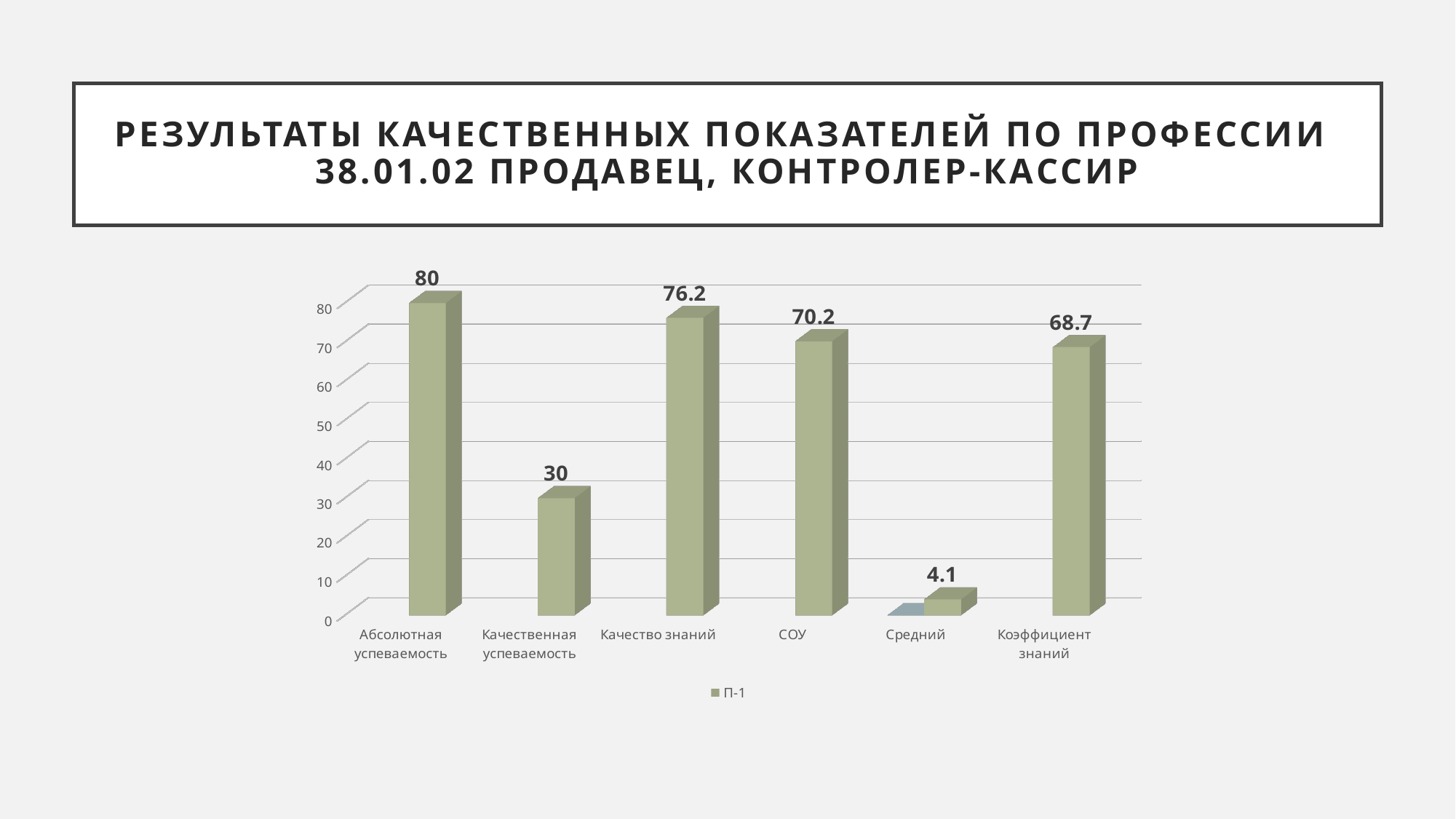
What is the value for Качественная успеваемость? 30 What is the difference between the values for Абсолютная успеваемость and Качественная успеваемость? 50 What is the value for Коэффициент знаний? 68.7 What is the value for СОУ? 70.2 How many series does the legend list? 1 Which is larger, the value for Качество знаний or the value for СОУ? Качество знаний How many categories are shown on the x axis? 6 What is the value for Качество знаний? 76.2 What is the value for Абсолютная успеваемость? 80 Which category has the lowest value? Средний What kind of chart is shown on the slide? Bar chart Which category has the highest value? Абсолютная успеваемость